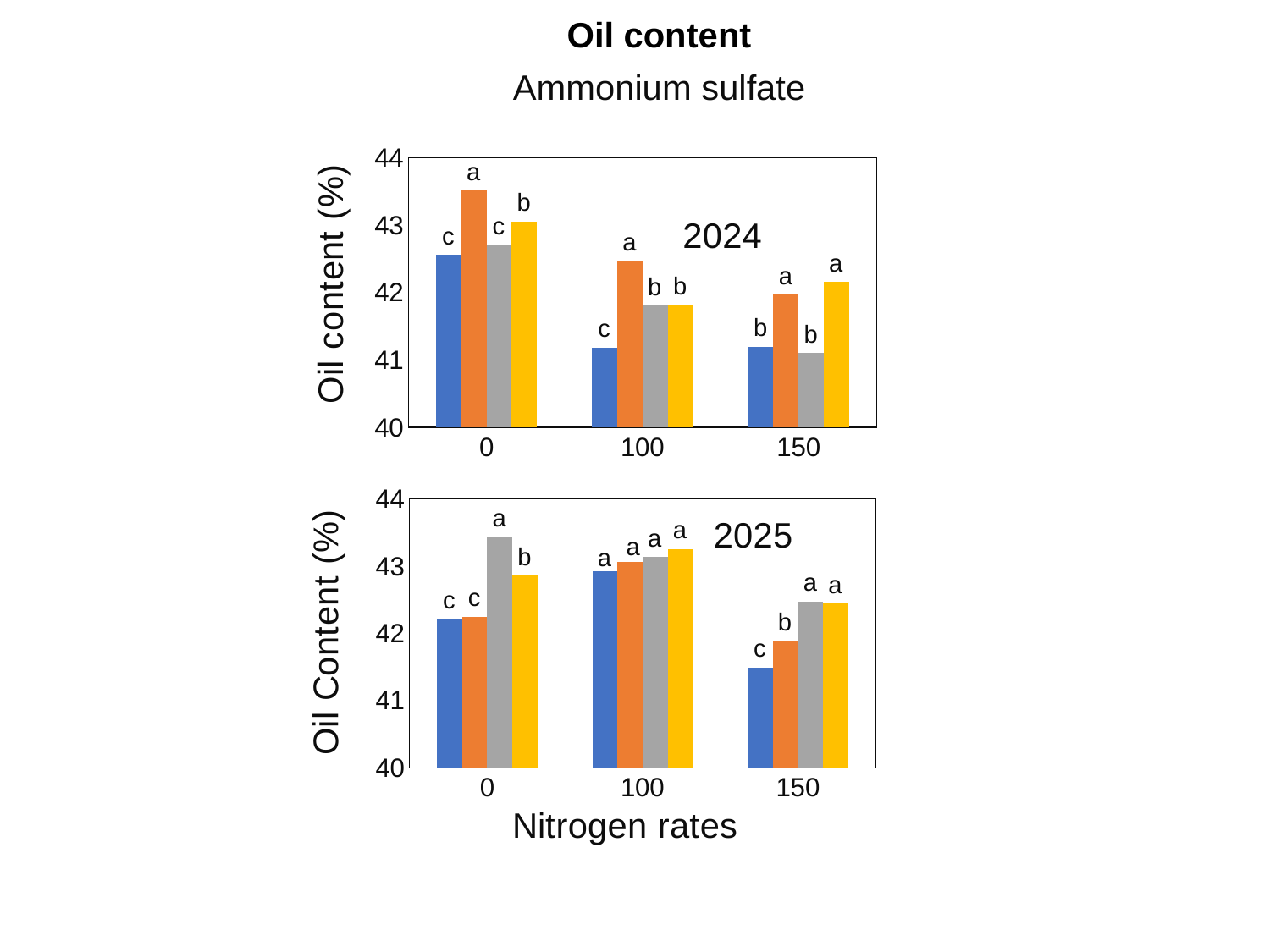
In the 2024 chart, which bar is lowest at nitrogen rate 100? the blue bar In the 2024 chart, is the blue bar at nitrogen rate 100 greater or less than 42? less How many nitrogen rate categories are shown on the x axis of the 2025 chart? 3 In the 2025 chart, is the blue bar at nitrogen rate 150 greater or less than 42? less In the 2024 chart, how many bars are plotted for each nitrogen rate? 4 In the 2025 chart, which bar is lowest at nitrogen rate 150? the blue bar In the 2024 chart, is the orange bar at nitrogen rate 0 greater or less than 43? greater In the 2025 chart, which bar is highest at nitrogen rate 0? the grey bar In the 2025 chart at nitrogen rate 150, which is larger, the grey bar or the blue bar? the grey bar In the 2024 chart, which bar is highest at nitrogen rate 0? the orange bar What is the x-axis label of the 2025 chart? Nitrogen rates What kind of chart is the 2024 chart? bar chart